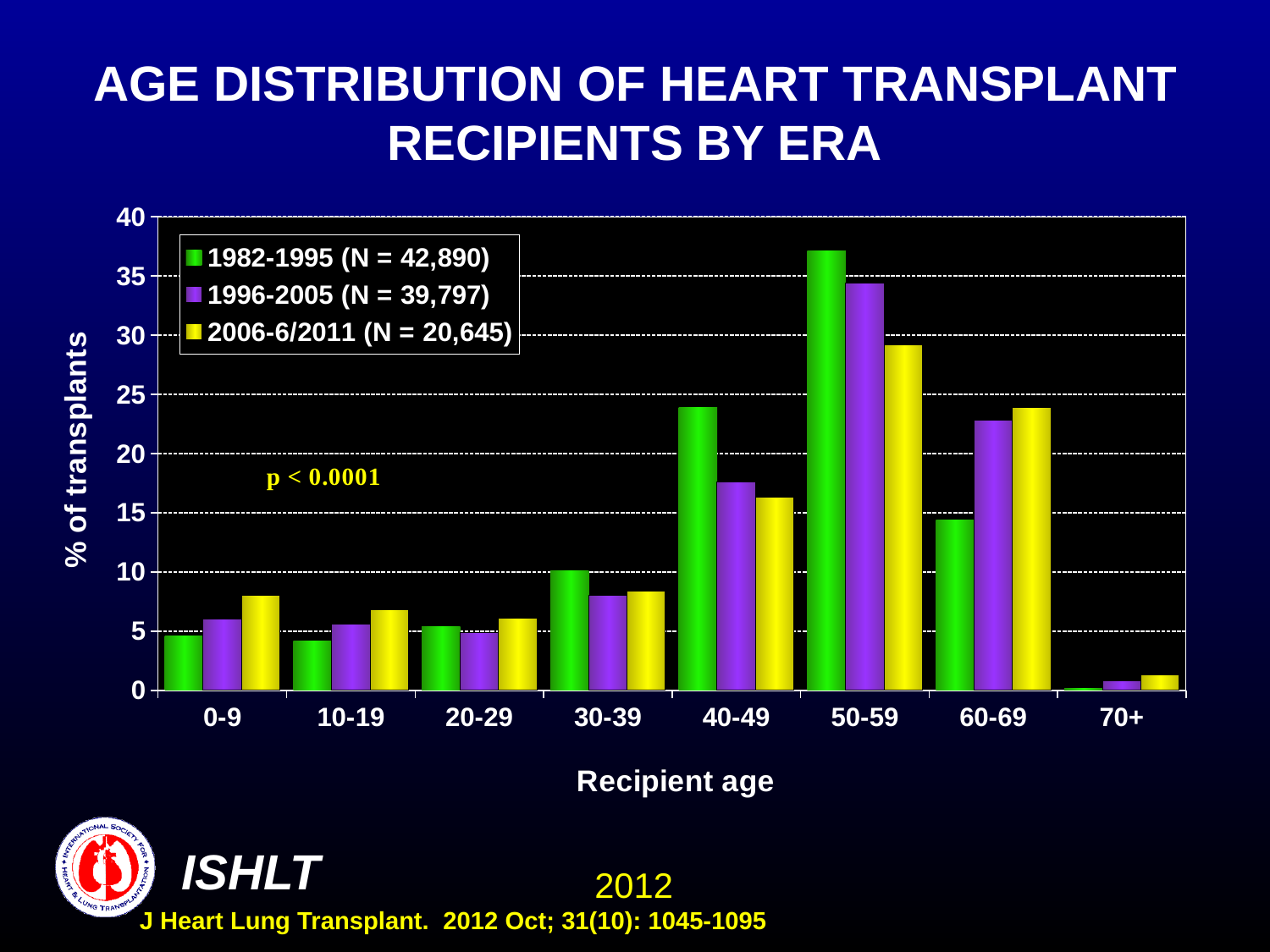
According to the legend, what is the N for the 1982-1995 era? 42,890 For the 1982-1995 era, which recipient age group has the highest percentage of transplants? 50-59 In the 40-49 age group, which era has the larger percentage: 1982-1995 or 1996-2005? 1982-1995 Is the value for the 2006-6/2011 era in the 50-59 age group greater or less than 30? less How many series does the legend list? 3 Is the value for the 1982-1995 era in the 50-59 age group greater or less than 35? greater Is the value for the 1996-2005 era in the 60-69 age group greater or less than 20? greater How many recipient age groups are shown on the x axis? 8 What kind of chart is shown on the slide? bar chart In the 0-9 age group, which era has the highest percentage of transplants? 2006-6/2011 For the 1982-1995 era, which recipient age group has the lowest percentage of transplants? 70+ In the 60-69 age group, which era has the larger percentage: 1982-1995 or 2006-6/2011? 2006-6/2011